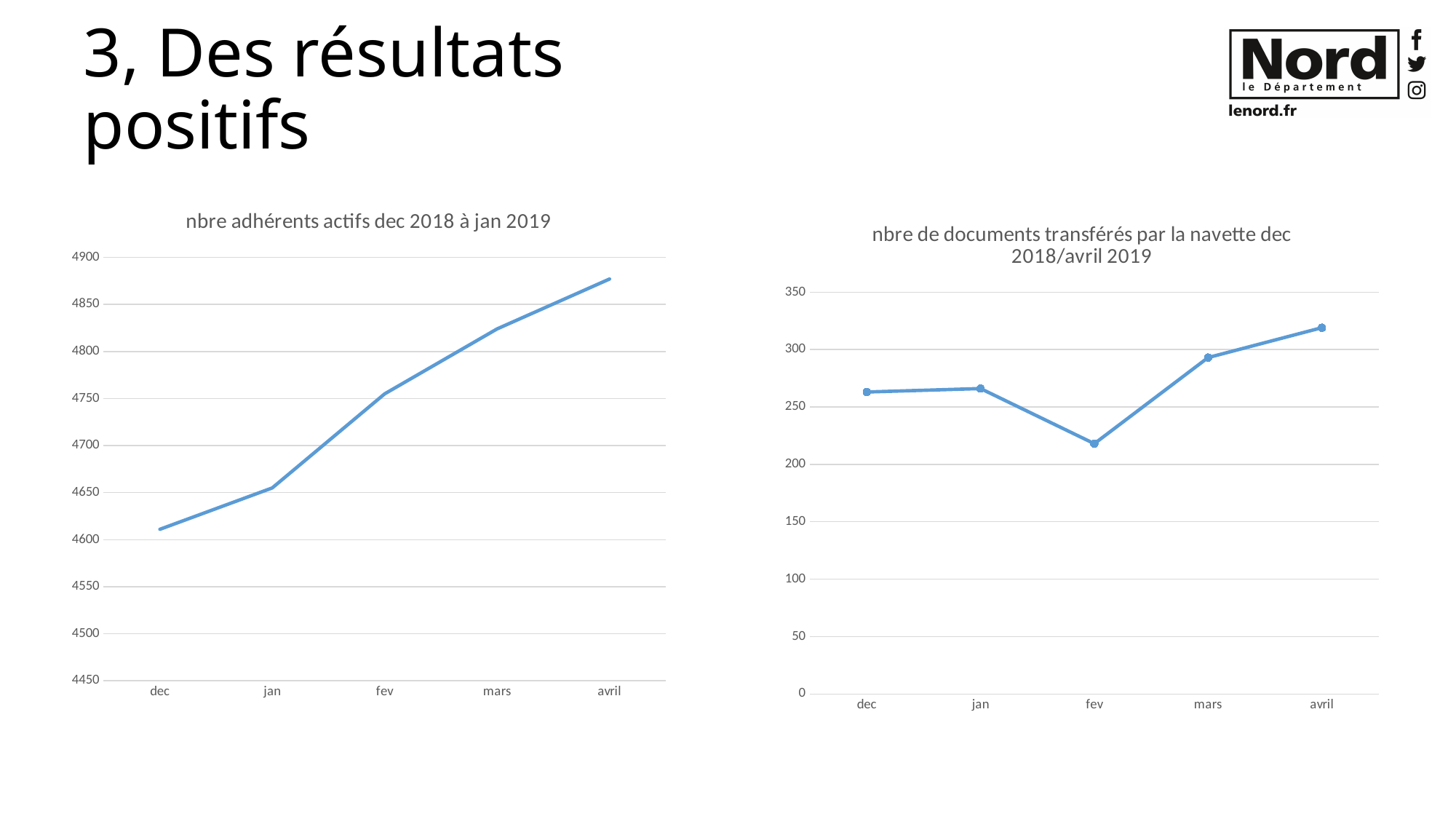
In the right chart 'nbre de documents transférés par la navette', which month has the highest value? avril In the right chart 'nbre de documents transférés par la navette', which is larger, the value for mars or the value for fev? mars In the left chart 'nbre adhérents actifs', how many months are plotted on the x axis? 5 In the left chart 'nbre adhérents actifs', is the value for dec greater or less than 4650? less What kind of chart is the left chart titled 'nbre adhérents actifs dec 2018 à jan 2019'? line chart In the left chart 'nbre adhérents actifs', which month has the lowest value? dec In the right chart 'nbre de documents transférés par la navette', is the value for fev greater or less than 250? less In the left chart 'nbre adhérents actifs', which month has the highest value? avril What kind of chart is the right chart titled 'nbre de documents transférés par la navette dec 2018/avril 2019'? line chart In the left chart 'nbre adhérents actifs', is the value for fev greater or less than 4700? greater In the right chart 'nbre de documents transférés par la navette', which month has the lowest value? fev In the left chart 'nbre adhérents actifs', do the values rise or fall from dec to avril? rise